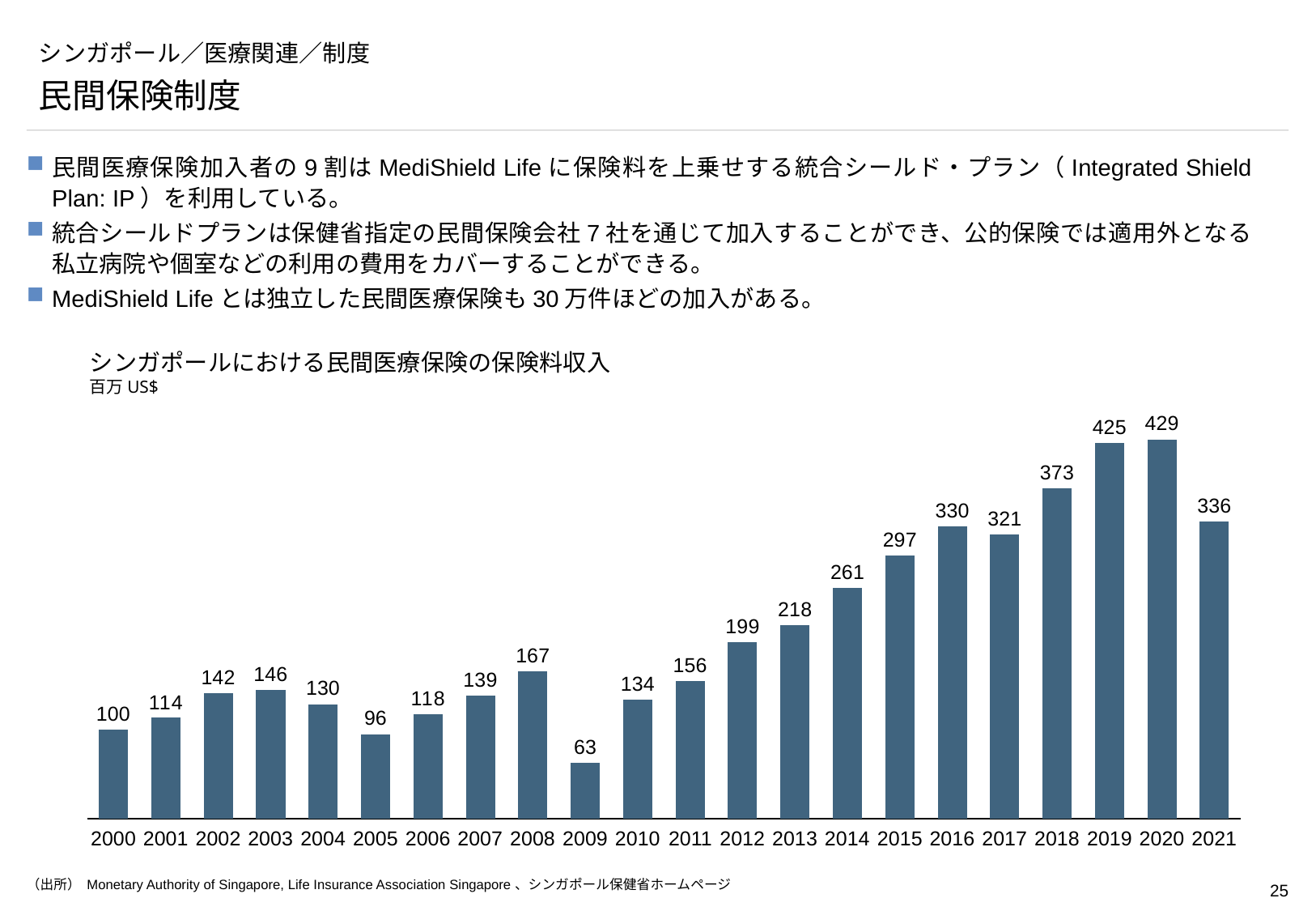
Which year has the highest value? 2020 Which year has the lowest value? 2009 What kind of chart is shown on the slide? Bar chart What is the difference between the values for 2000 and 2019? 325 Do the values generally rise or fall from 2009 to 2020? Rise What unit is shown under the chart title? 百万 US$ What is the value for 2018? 373 Which is larger, the value for 2003 or the value for 2004? 2003 What is the difference between the values for 2020 and 2021? 93 How many years are shown on the x axis? 22 What is the value for 2009? 63 Which is larger, the value for 2016 or the value for 2017? 2016